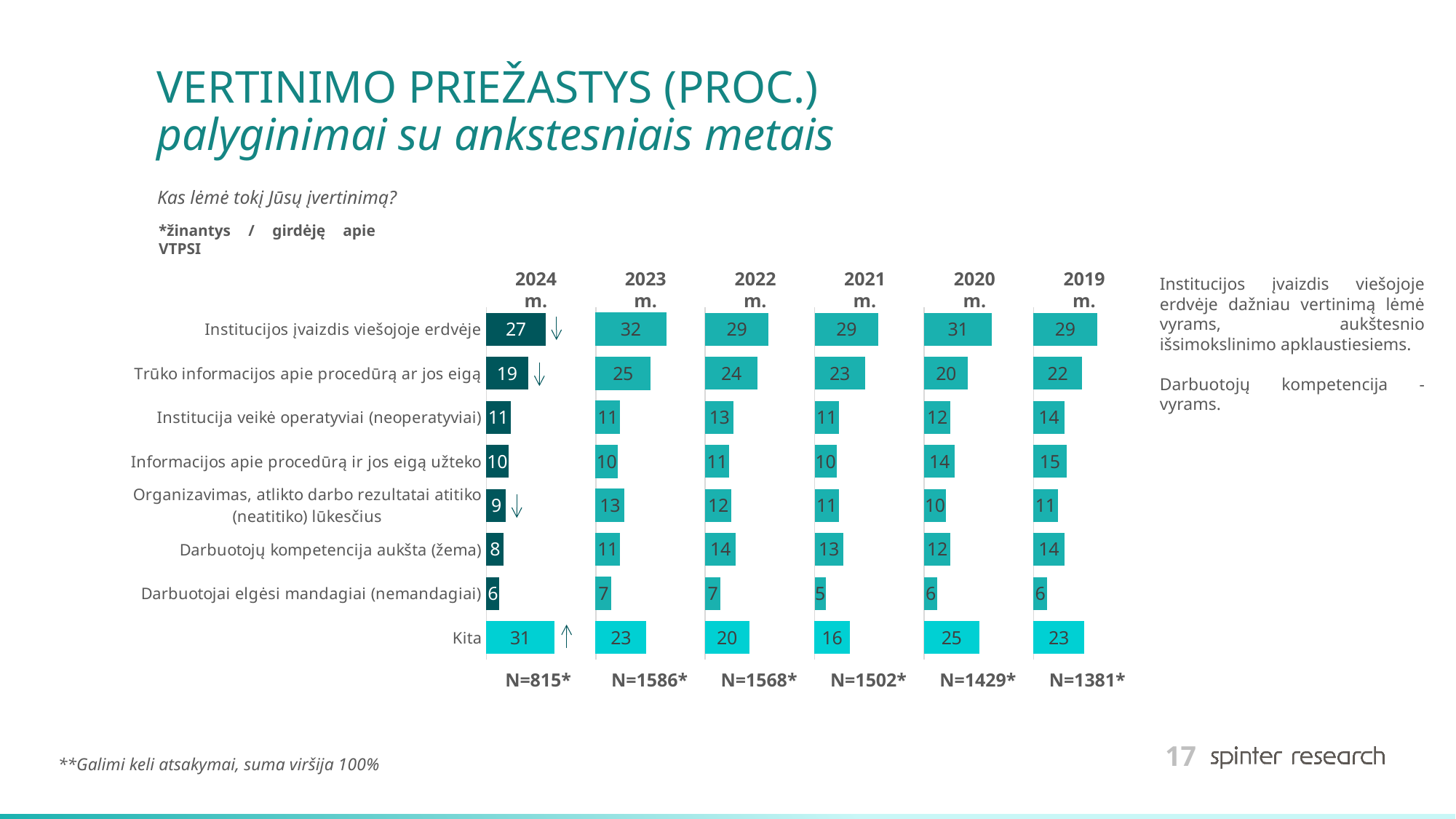
How many categories are shown in each year's chart? 8 In the 2019 m. chart, what is the value for Informacijos apie procedūrą ir jos eigą užteko? 15 In the 2024 m. chart, what is the value for Institucijos įvaizdis viešojoje erdvėje? 27 What is the sample size (N) shown for the 2022 m. chart? N=1568* How many years are compared on the slide? 6 In the 2024 m. chart, which category has the highest value? Kita What is the difference between the 2023 m. and 2024 m. values for Institucijos įvaizdis viešojoje erdvėje? 5 In the 2020 m. chart, what is the value for Darbuotojų kompetencija aukšta (žema)? 12 Which is larger: the value for Kita in the 2020 m. chart or in the 2021 m. chart? 2020 m. In the 2021 m. chart, which category has the lowest value? Darbuotojai elgėsi mandagiai (nemandagiai) What kind of chart is used on the slide? Bar chart In the 2023 m. chart, what is the value for Trūko informacijos apie procedūrą ar jos eigą? 25